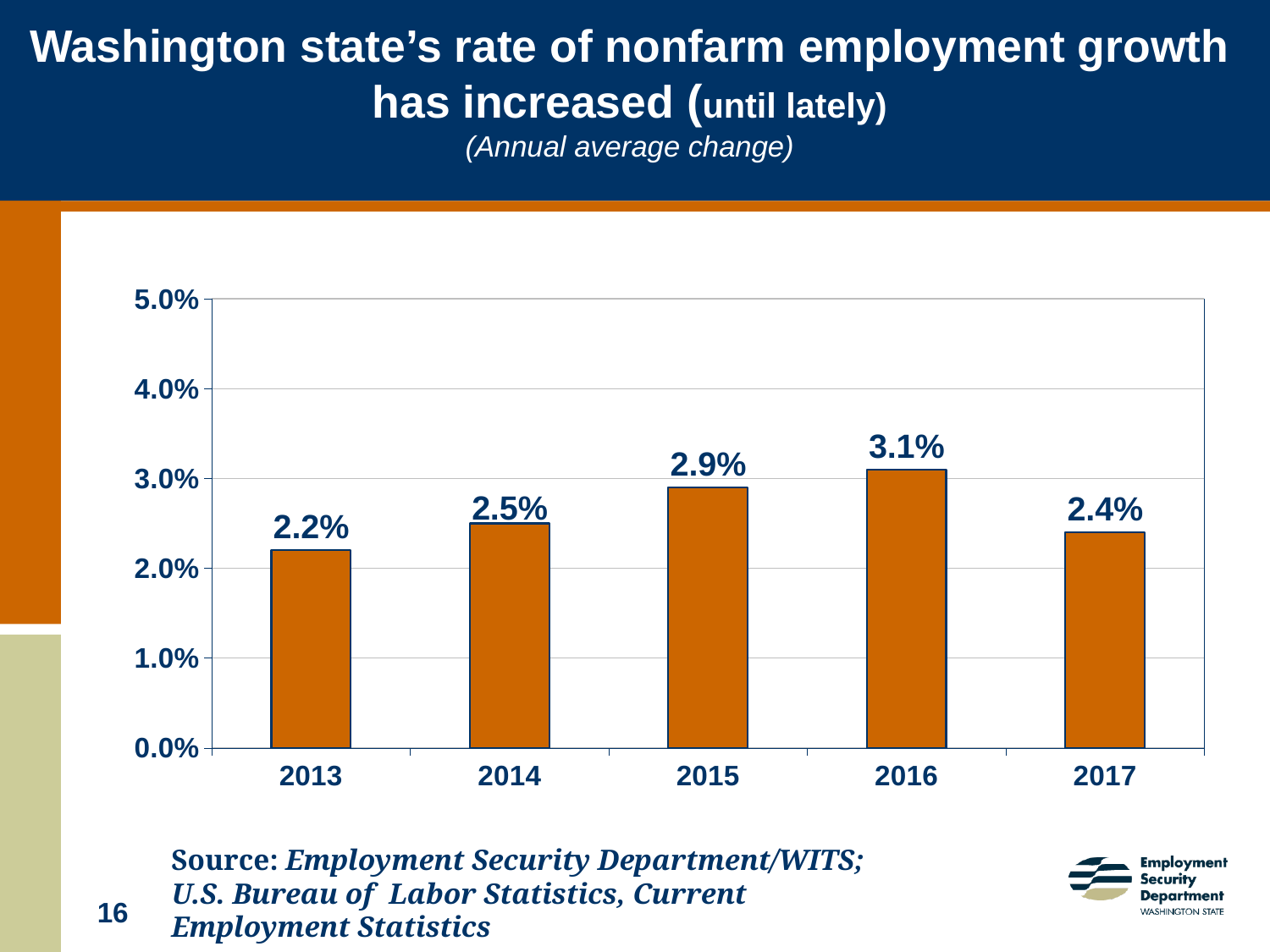
What is the difference between the 2016 value and the 2017 value? 0.7% What kind of chart is shown on the slide? Bar chart Is the value for 2016 greater or less than 3.0%? greater What is the difference between the 2015 value and the 2014 value? 0.4% What value is shown for 2017? 2.4% How many years are shown on the chart? 5 Which year has the lowest rate of nonfarm employment growth? 2013 Which year has the highest rate of nonfarm employment growth? 2016 Do the values rise or fall from 2013 to 2016? Rise Which year has the larger value, 2014 or 2017? 2014 What was the annual average change in nonfarm employment in 2013? 2.2% What value is shown for 2016? 3.1%